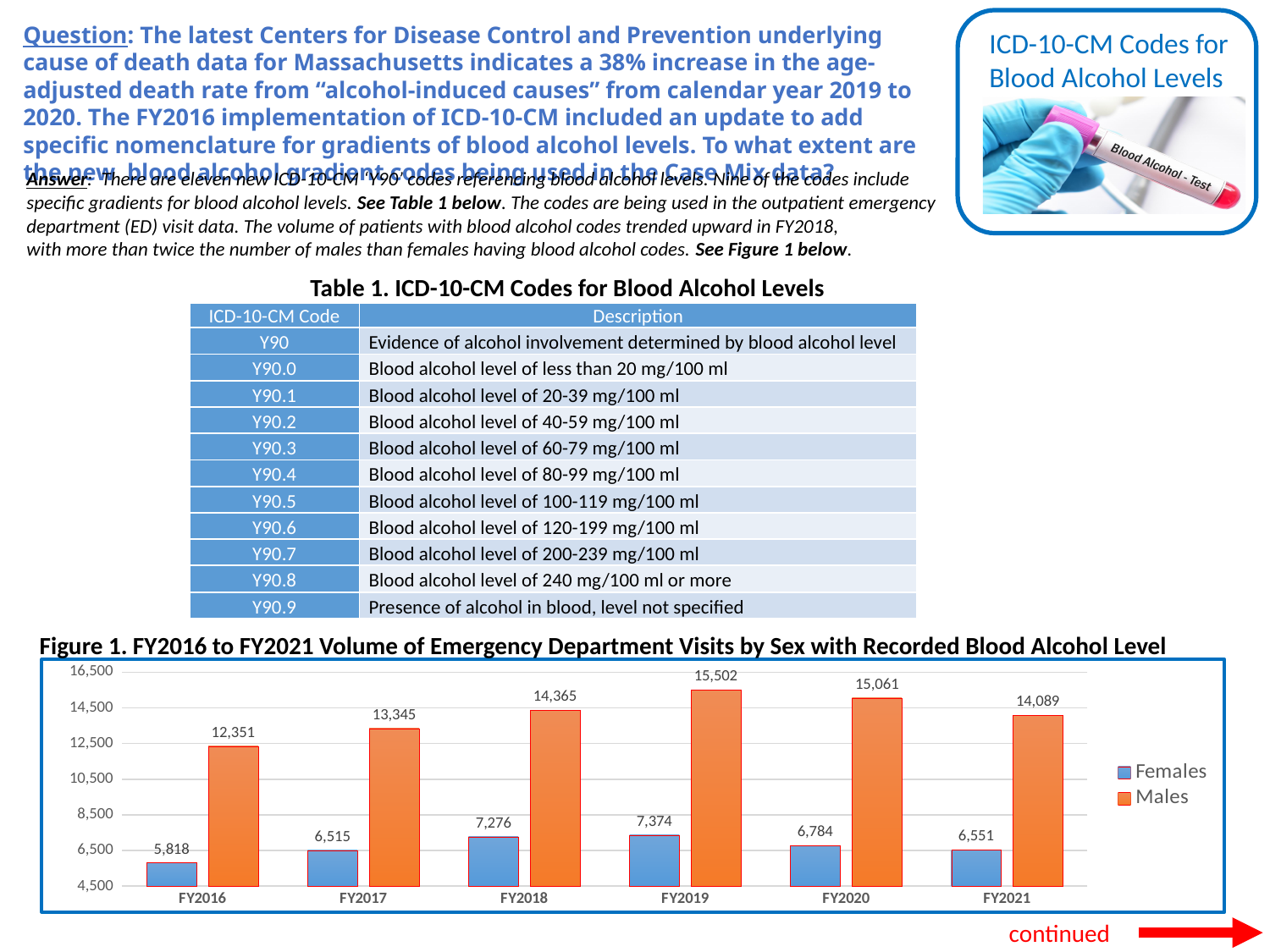
In which fiscal year is the Males value highest? FY2019 What kind of chart is Figure 1? bar chart What is the value for Females in FY2020? 6,784 What is the value for Females in FY2016? 5,818 What is the value for Males in FY2019? 15,502 In which fiscal year is the Females value lowest? FY2016 Is the value for Males in FY2017 greater or less than 12,500? greater What is the difference between the Males and Females values in FY2018? 7,089 Which colour represents Males in the chart? orange How many series does the legend list? 2 Which is larger, the Females value in FY2019 or the Females value in FY2021? FY2019 How many fiscal years are shown on the x axis? 6